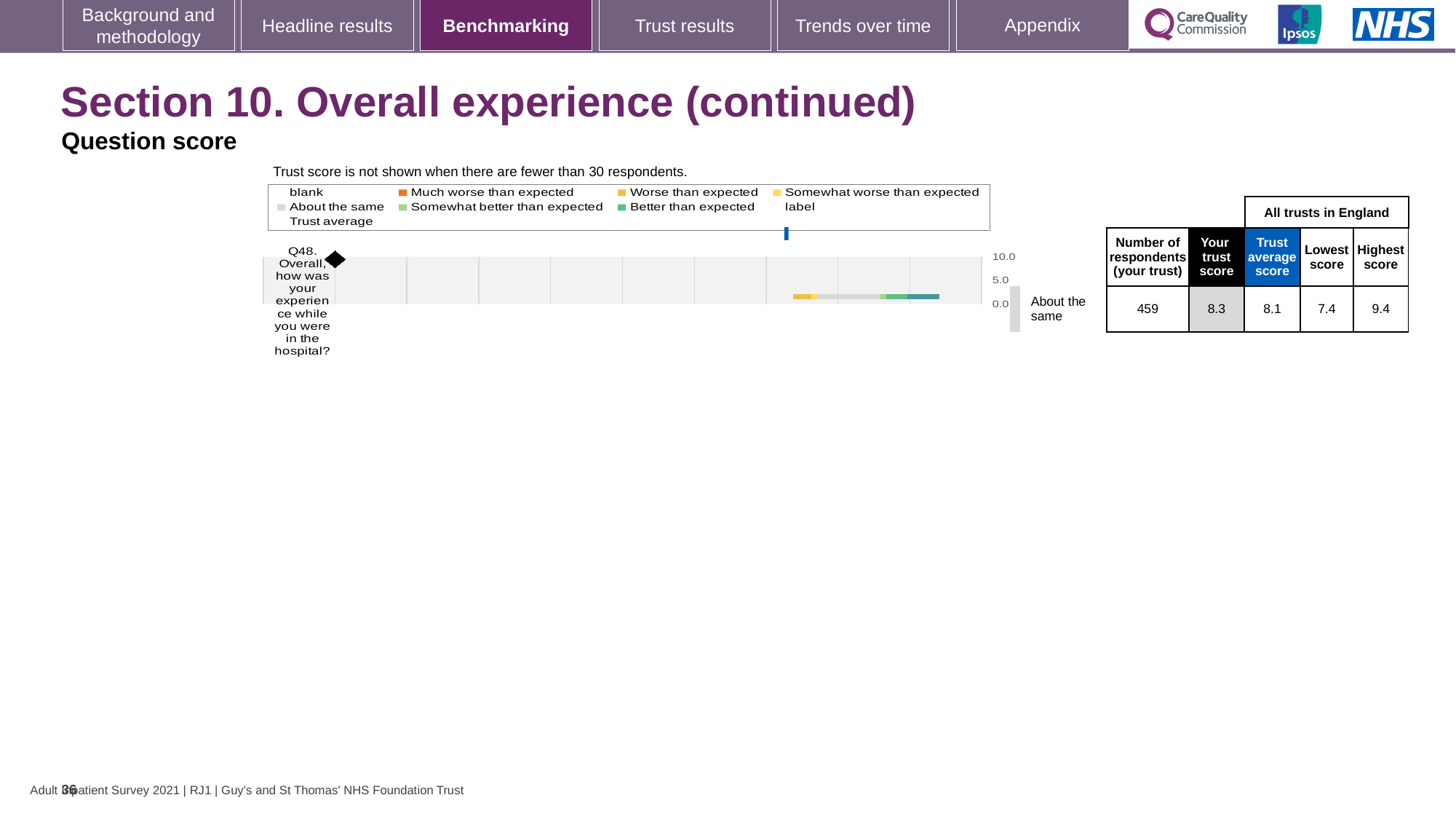
What is the trust average score for Q48 across all trusts in England? 8.1 What benchmark category label is shown next to the Q48 bar? About the same What is the lowest score for Q48 across all trusts in England? 7.4 What is the difference between the highest score and the lowest score for Q48? 2.0 What kind of chart is used to show the Q48 question score? bar chart Which question is plotted on the chart? Q48. Overall, how was your experience while you were in the hospital? What is your trust score for Q48? 8.3 By how much does your trust score for Q48 exceed the trust average score? 0.2 What is the highest score for Q48 across all trusts in England? 9.4 What is the number of respondents (your trust) for Q48? 459 Which is larger for Q48: your trust score or the trust average score? Your trust score How many survey questions are plotted on the chart? 1